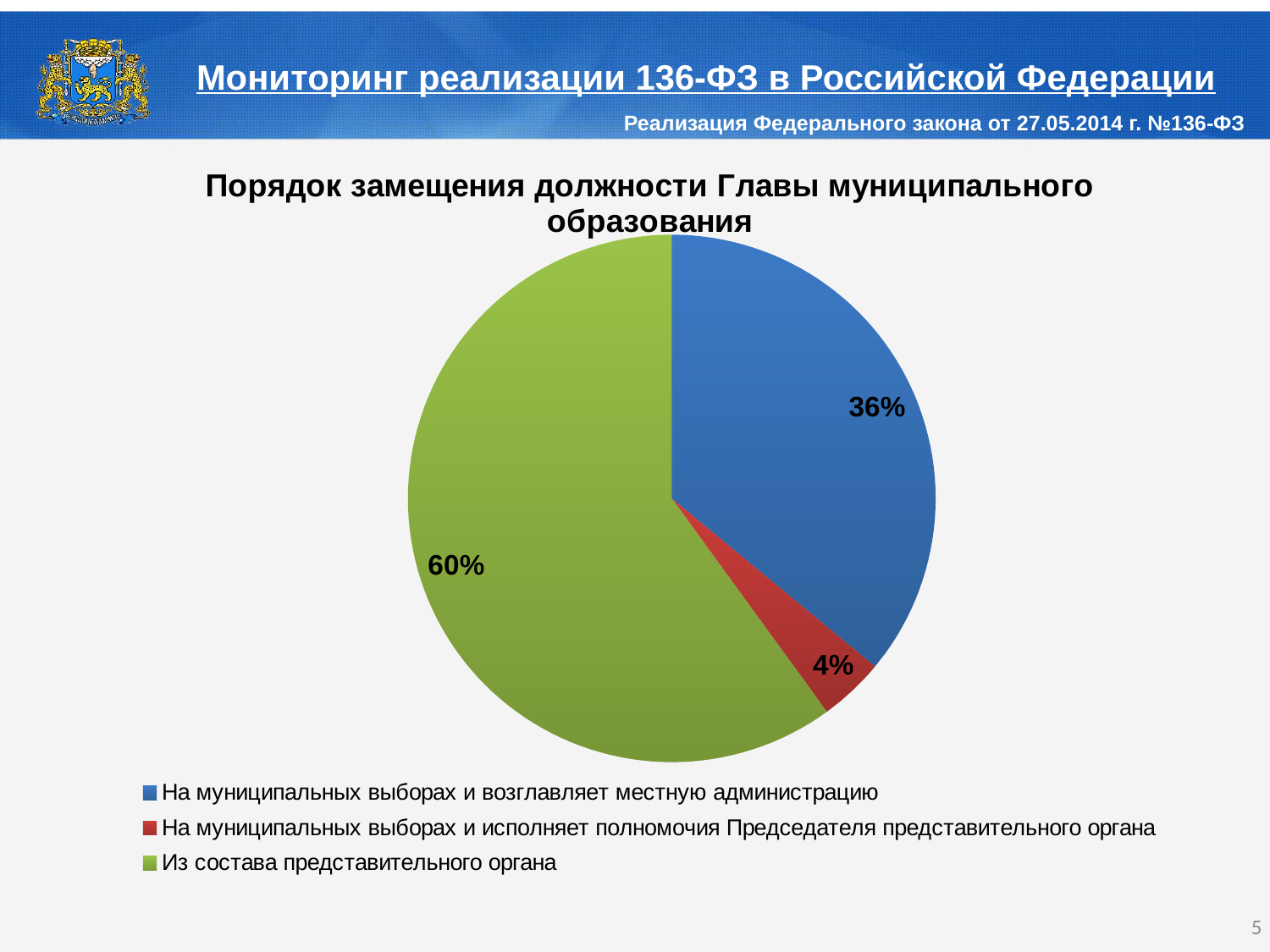
What share of the pie is 'На муниципальных выборах и возглавляет местную администрацию'? 36% What colour is the slice for 'Из состава представительного органа'? green Which category has the largest share of the pie? Из состава представительного органа What is the title of the chart? Порядок замещения должности Главы муниципального образования What is the combined share of the two categories elected at municipal elections ('На муниципальных выборах...')? 40% Which is larger: the share for 'На муниципальных выборах и возглавляет местную администрацию' or the share for 'На муниципальных выборах и исполняет полномочия Председателя представительного органа'? На муниципальных выборах и возглавляет местную администрацию What type of chart is shown on the slide? pie chart What share of the pie is 'На муниципальных выборах и исполняет полномочия Председателя представительного органа'? 4% What is the difference in percentage points between 'Из состава представительного органа' and 'На муниципальных выборах и возглавляет местную администрацию'? 24 How many categories does the pie chart have? 3 Which category has the smallest share of the pie? На муниципальных выборах и исполняет полномочия Председателя представительного органа What share of the pie is 'Из состава представительного органа'? 60%